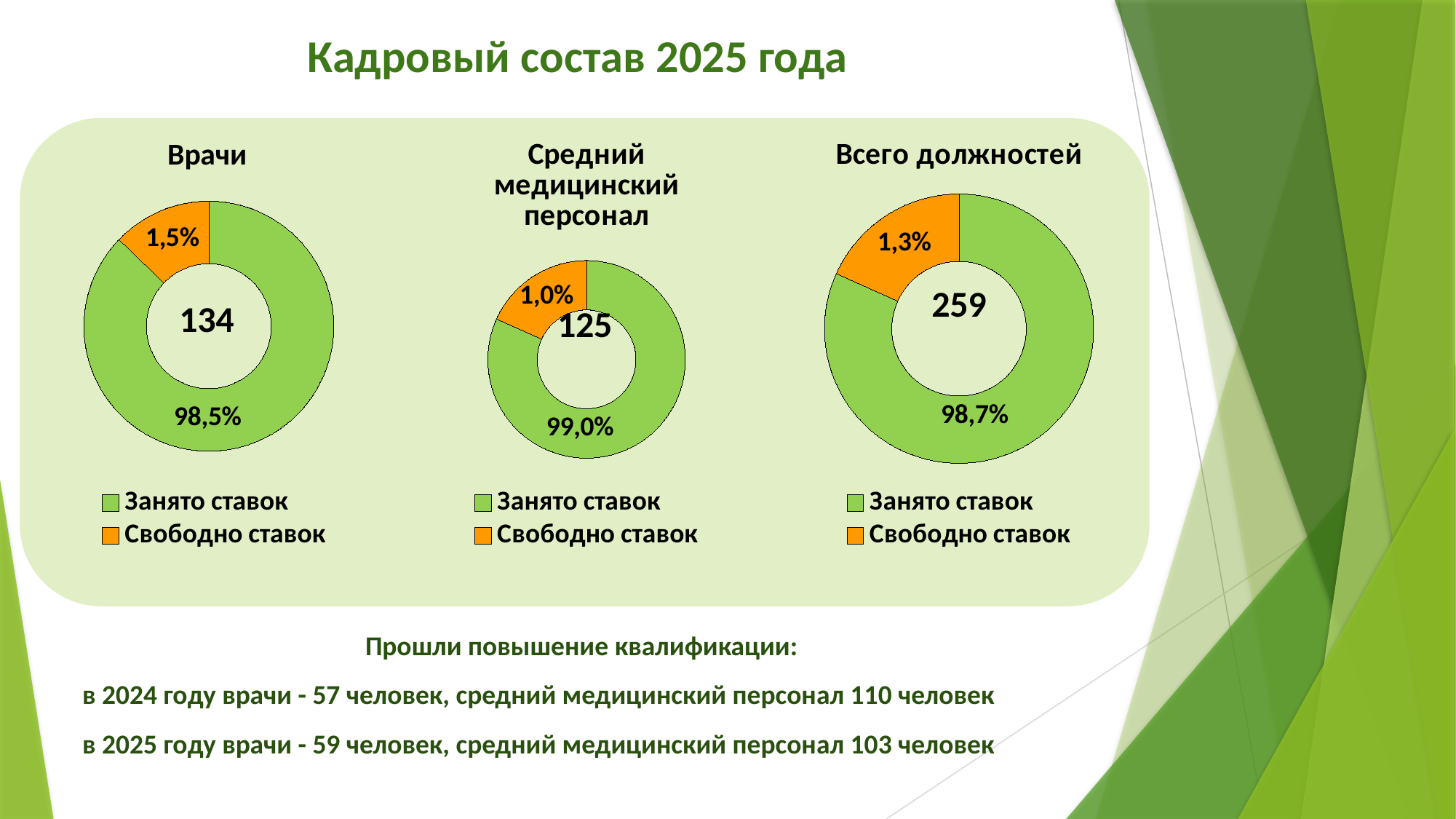
In the "Всего должностей" chart, what share is labelled for "Занято ставок"? 98,7% In the "Врачи" chart, which slice is larger: "Занято ставок" or "Свободно ставок"? Занято ставок In the "Врачи" chart, what share is labelled for "Занято ставок"? 98,5% What number is printed in the centre of the "Врачи" chart? 134 In the "Врачи" chart, what share is labelled for "Свободно ставок"? 1,5% What kind of chart is used for "Средний медицинский персонал"? Doughnut chart How many entries does the legend of the "Всего должностей" chart list? 2 What number is printed in the centre of the "Всего должностей" chart? 259 In the "Средний медицинский персонал" chart, what colour is the "Свободно ставок" slice? Orange In the "Средний медицинский персонал" chart, what share is labelled for "Занято ставок"? 99,0% In the "Средний медицинский персонал" chart, what share is labelled for "Свободно ставок"? 1,0% In the "Всего должностей" chart, what share is labelled for "Свободно ставок"? 1,3%